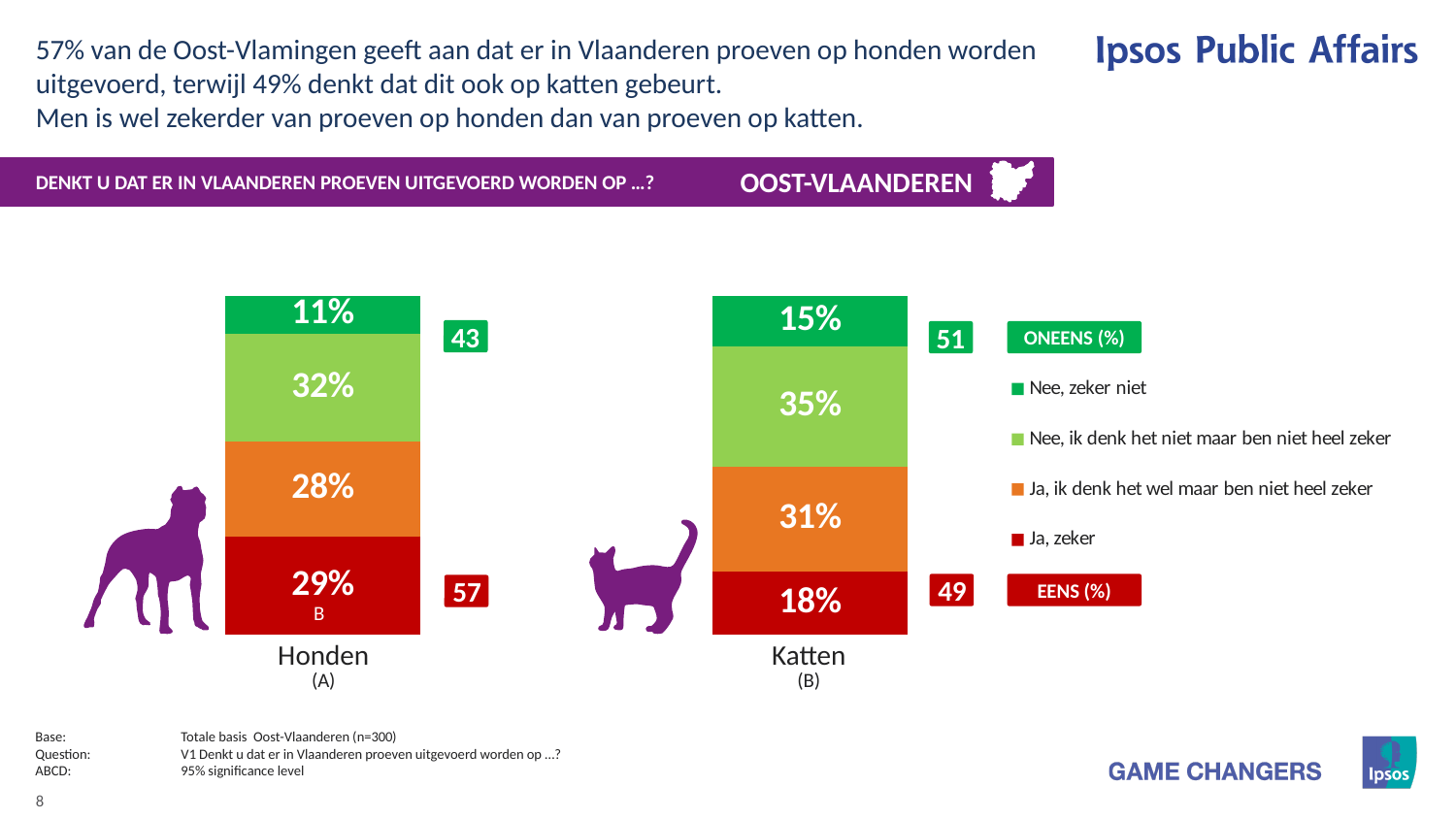
What percentage of respondents answered "Nee, ik denk het niet maar ben niet heel zeker" for Honden? 32% What percentage of respondents answered "Ja, zeker" for Honden? 29% Which category has the higher "Ja, zeker" percentage, Honden or Katten? Honden Which response option has the smallest share for Honden? Nee, zeker niet What percentage of respondents answered "Nee, zeker niet" for Katten? 15% What is the EENS (%) value shown for Honden? 57 What is the difference between the "Ja, zeker" percentages for Honden and Katten? 11% What type of chart is shown on the slide? Stacked bar chart How many series does the legend list? 4 Which response option has the largest share for Katten? Nee, ik denk het niet maar ben niet heel zeker What percentage of respondents answered "Ja, zeker" for Katten? 18% What is the ONEENS (%) value shown for Katten? 51